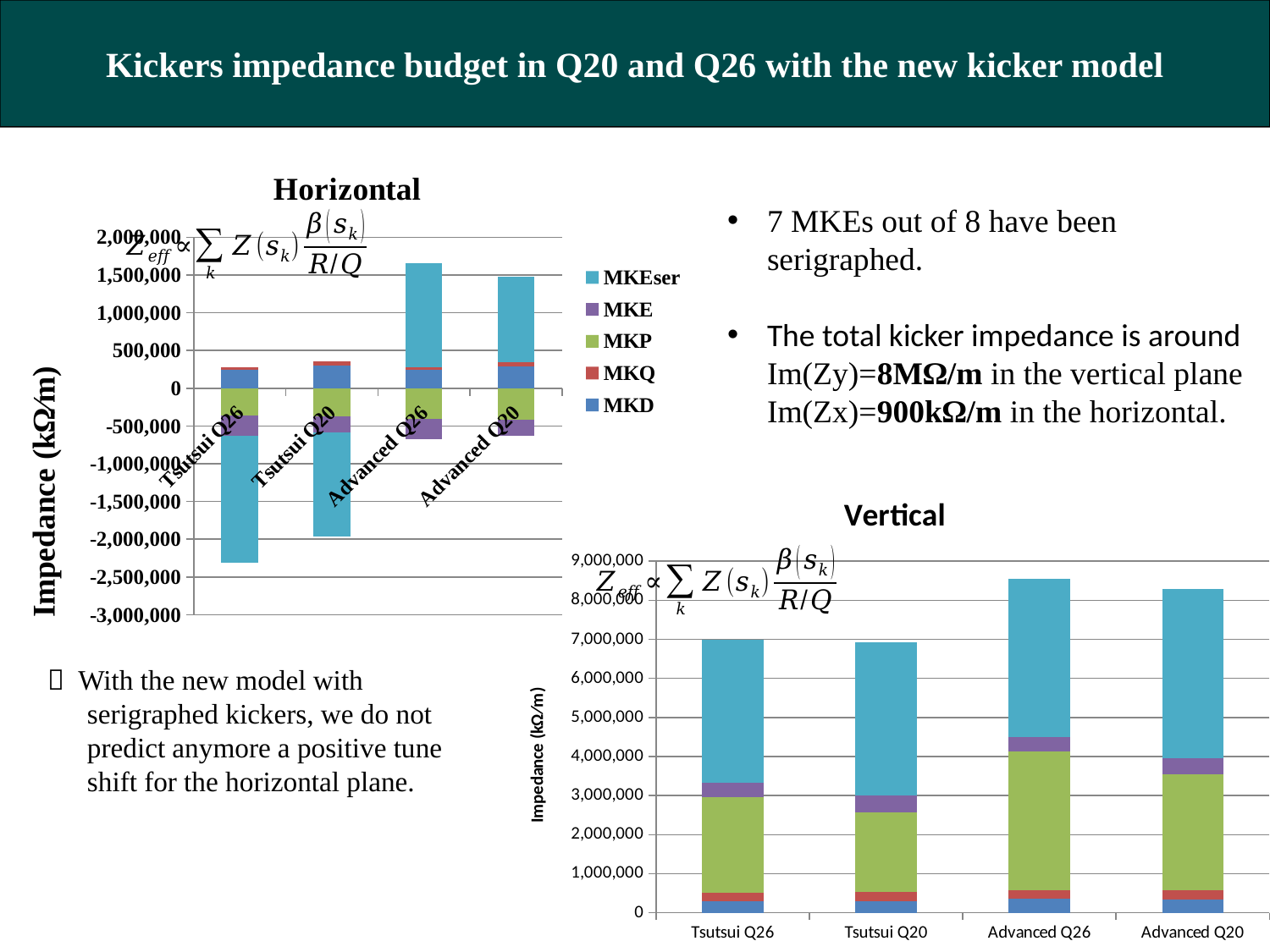
Which legend entry is listed first in the Horizontal chart? MKEser How many series does the legend of the Horizontal chart list? 5 In the Vertical chart, which category has the tallest stacked bar? Advanced Q26 In the Vertical chart, is the top of the stacked bar for Tsutsui Q20 greater or less than 7,000,000? less What is the y-axis label of the Vertical chart? Impedance (kΩ/m) What kind of chart is the Horizontal chart? bar chart In the Horizontal chart, is the top of the positive stack for Advanced Q26 greater or less than 1,500,000? greater In the Vertical chart, which stacked bar is taller: Advanced Q26 or Tsutsui Q20? Advanced Q26 In the Horizontal chart, which category has the largest positive stacked bar? Advanced Q26 In the Horizontal chart, is the bottom of the negative stack for Tsutsui Q26 greater or less than -2,000,000? less How many categories are shown on the x axis of the Vertical chart? 4